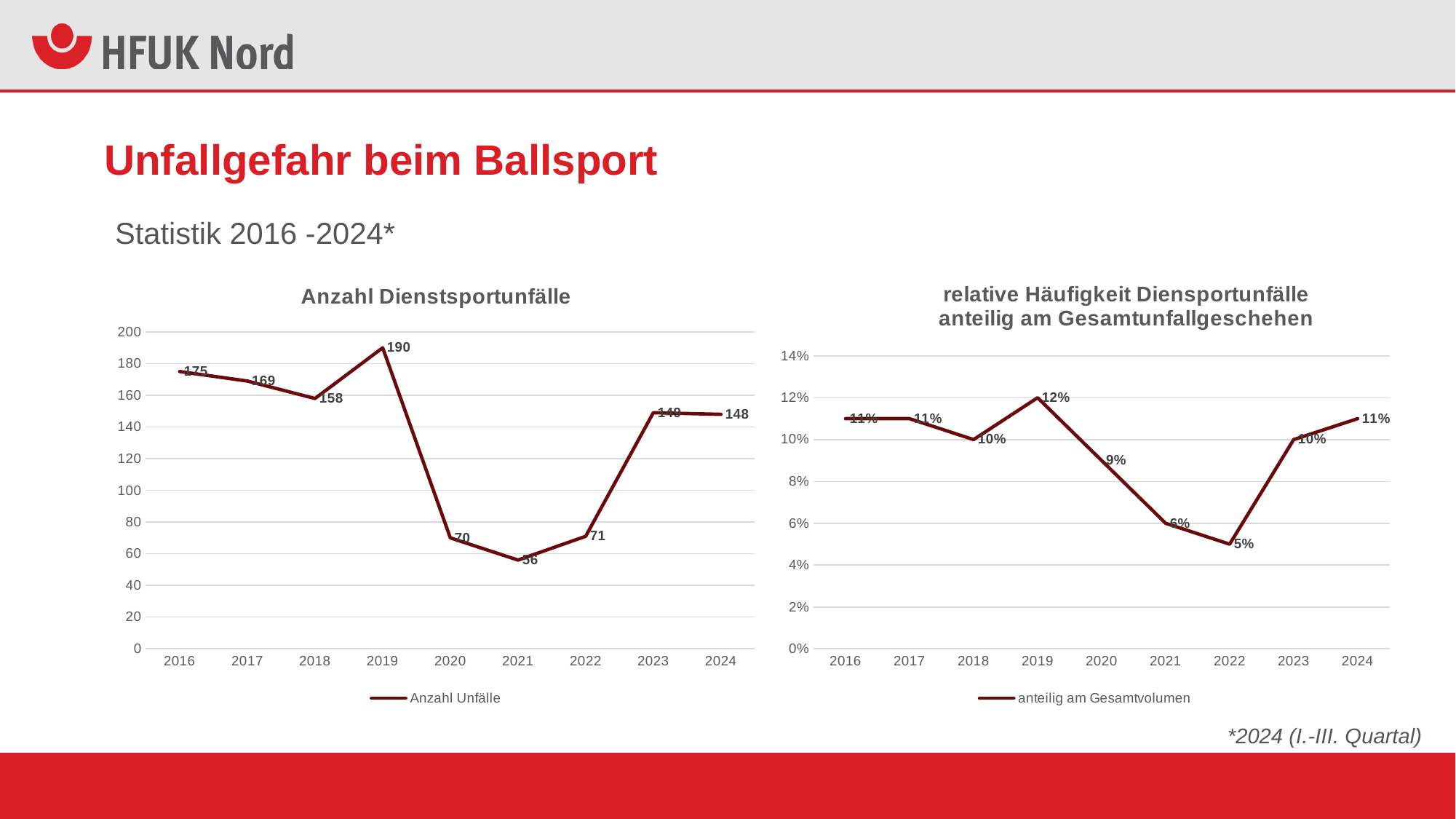
In the right chart "relative Häufigkeit Diensportunfälle anteilig am Gesamtunfallgeschehen", which year has the larger value, 2020 or 2021? 2020 In the left chart "Anzahl Dienstsportunfälle", what is the value for 2019? 190 In the left chart "Anzahl Dienstsportunfälle", how many years are plotted on the x axis? 9 In the left chart "Anzahl Dienstsportunfälle", do the values rise or fall from 2019 to 2021? fall In the left chart "Anzahl Dienstsportunfälle", what is the difference between the values for 2016 and 2021? 119 In the right chart "relative Häufigkeit Diensportunfälle anteilig am Gesamtunfallgeschehen", what is the value for 2022? 5% What is the legend entry of the right chart "relative Häufigkeit Diensportunfälle anteilig am Gesamtunfallgeschehen"? anteilig am Gesamtvolumen What kind of chart is the left chart titled "Anzahl Dienstsportunfälle"? line chart In the right chart "relative Häufigkeit Diensportunfälle anteilig am Gesamtunfallgeschehen", which year has the lowest value? 2022 In the left chart "Anzahl Dienstsportunfälle", which year has the highest value? 2019 In the right chart "relative Häufigkeit Diensportunfälle anteilig am Gesamtunfallgeschehen", which year has the highest value? 2019 In the left chart "Anzahl Dienstsportunfälle", which year has the lowest value? 2021